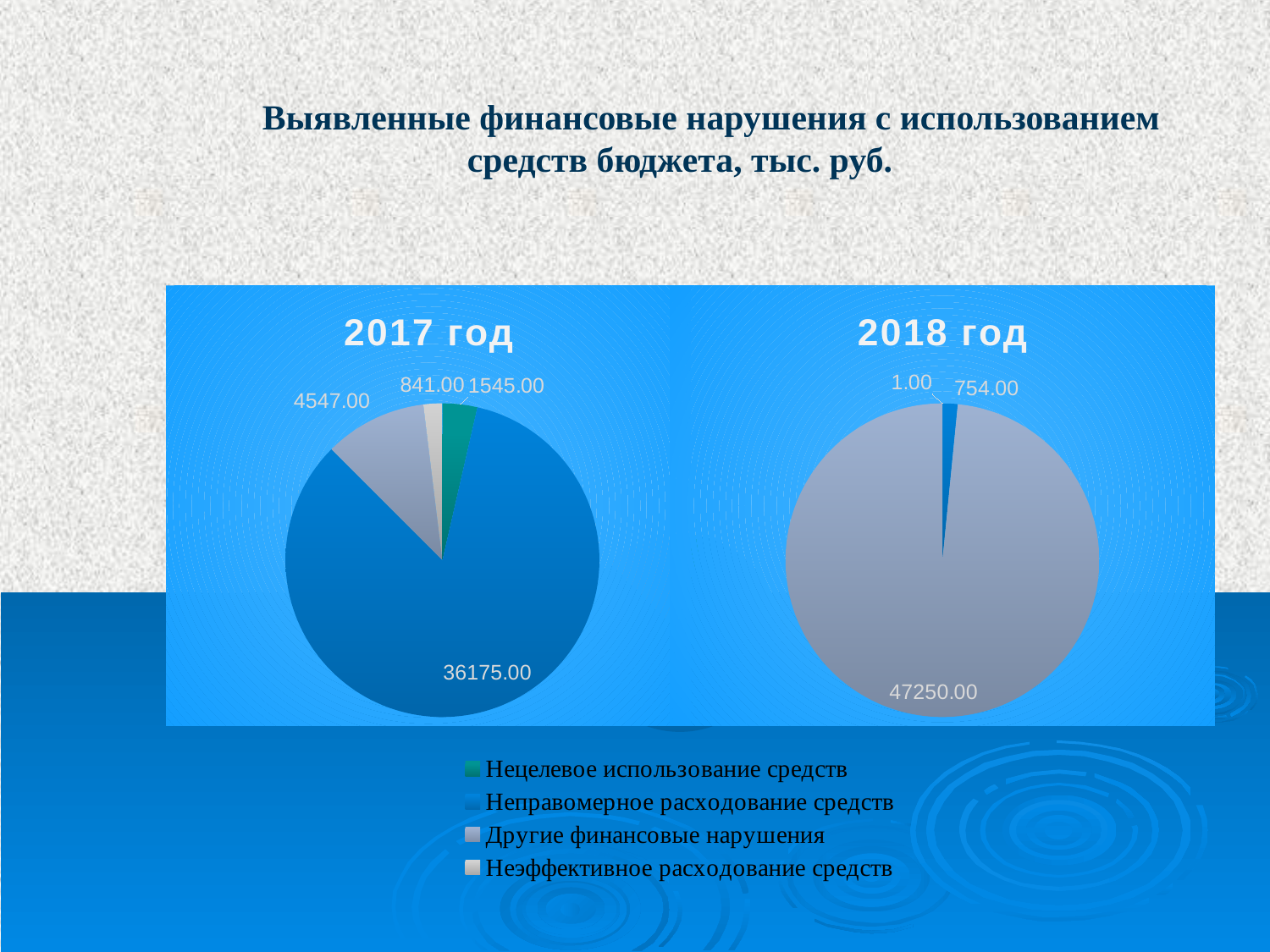
What is the total of all slices in the "2018 год" chart? 48005.00 In the "2017 год" chart, what is the value for Нецелевое использование средств? 1545.00 How many slices does the "2018 год" chart have? 3 In the "2018 год" chart, what is the value of the largest slice? 47250.00 In the "2017 год" chart, what is the value for Неправомерное расходование средств? 36175.00 In the "2017 год" chart, which category has the smallest slice? Неэффективное расходование средств In the "2017 год" chart, what is the difference between the values 36175.00 and 4547.00? 31628.00 In the "2017 год" chart, what is the value for Неэффективное расходование средств? 841.00 What is the total of all slices in the "2017 год" chart? 43108.00 What type of charts are shown on the slide? Pie charts In the "2017 год" chart, what is the value for Другие финансовые нарушения? 4547.00 How many entries does the legend list? 4